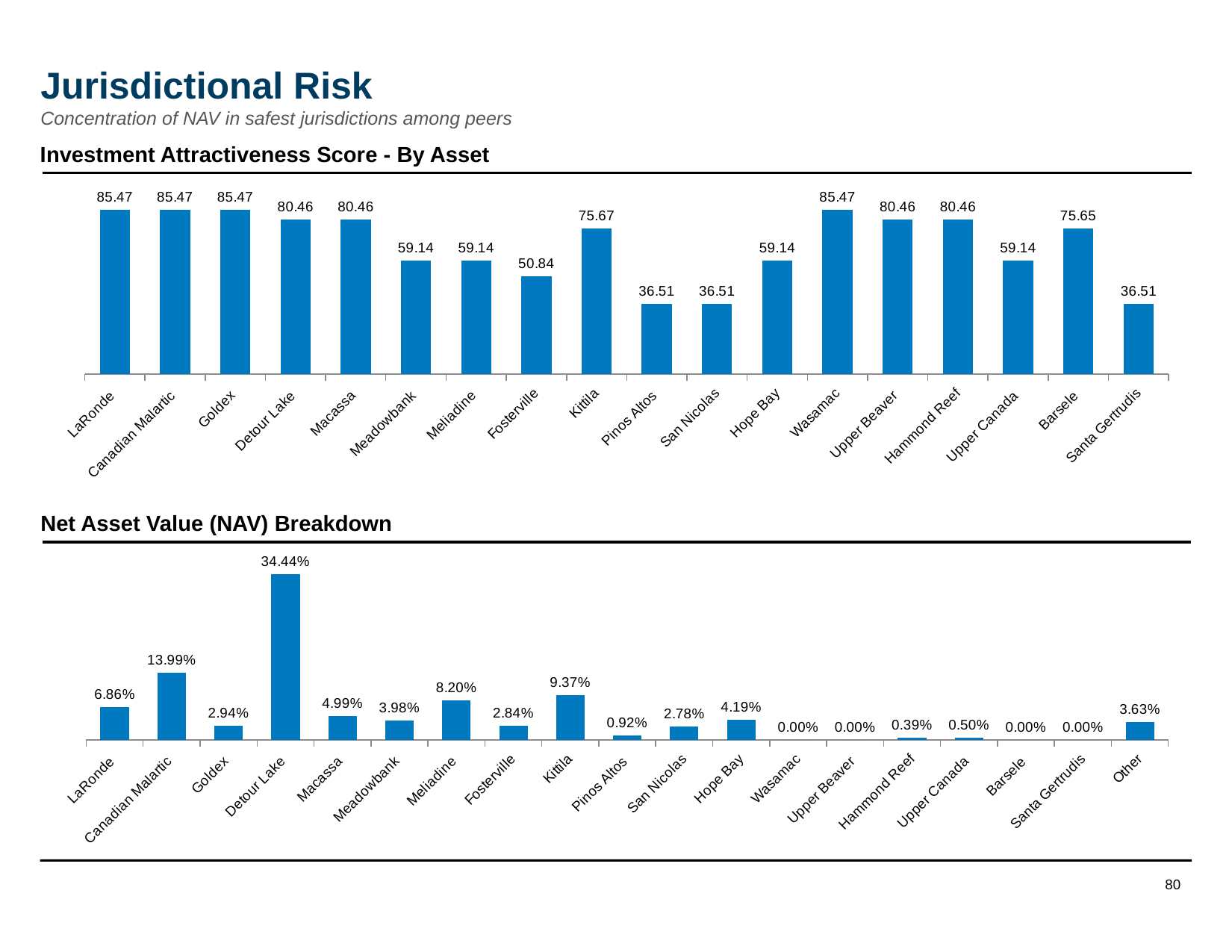
In the Investment Attractiveness Score - By Asset chart, what is the value for Fosterville? 50.84 In the Net Asset Value (NAV) Breakdown chart, which asset has the highest value? Detour Lake In the Investment Attractiveness Score - By Asset chart, which has the larger value, Hope Bay or Pinos Altos? Hope Bay How many assets are shown in the Investment Attractiveness Score - By Asset chart? 18 How many categories are shown in the Net Asset Value (NAV) Breakdown chart? 19 In the Investment Attractiveness Score - By Asset chart, what is the value for Kittila? 75.67 In the Investment Attractiveness Score - By Asset chart, what is the value for Barsele? 75.65 What type of chart is the Net Asset Value (NAV) Breakdown chart? Bar chart In the Net Asset Value (NAV) Breakdown chart, what is the value for Canadian Malartic? 13.99% In the Net Asset Value (NAV) Breakdown chart, what is the difference between the values for Kittila and Meliadine? 1.17% In the Investment Attractiveness Score - By Asset chart, what is the difference between the values for Detour Lake and Meadowbank? 21.32 In the Net Asset Value (NAV) Breakdown chart, what is the value for Hammond Reef? 0.39%